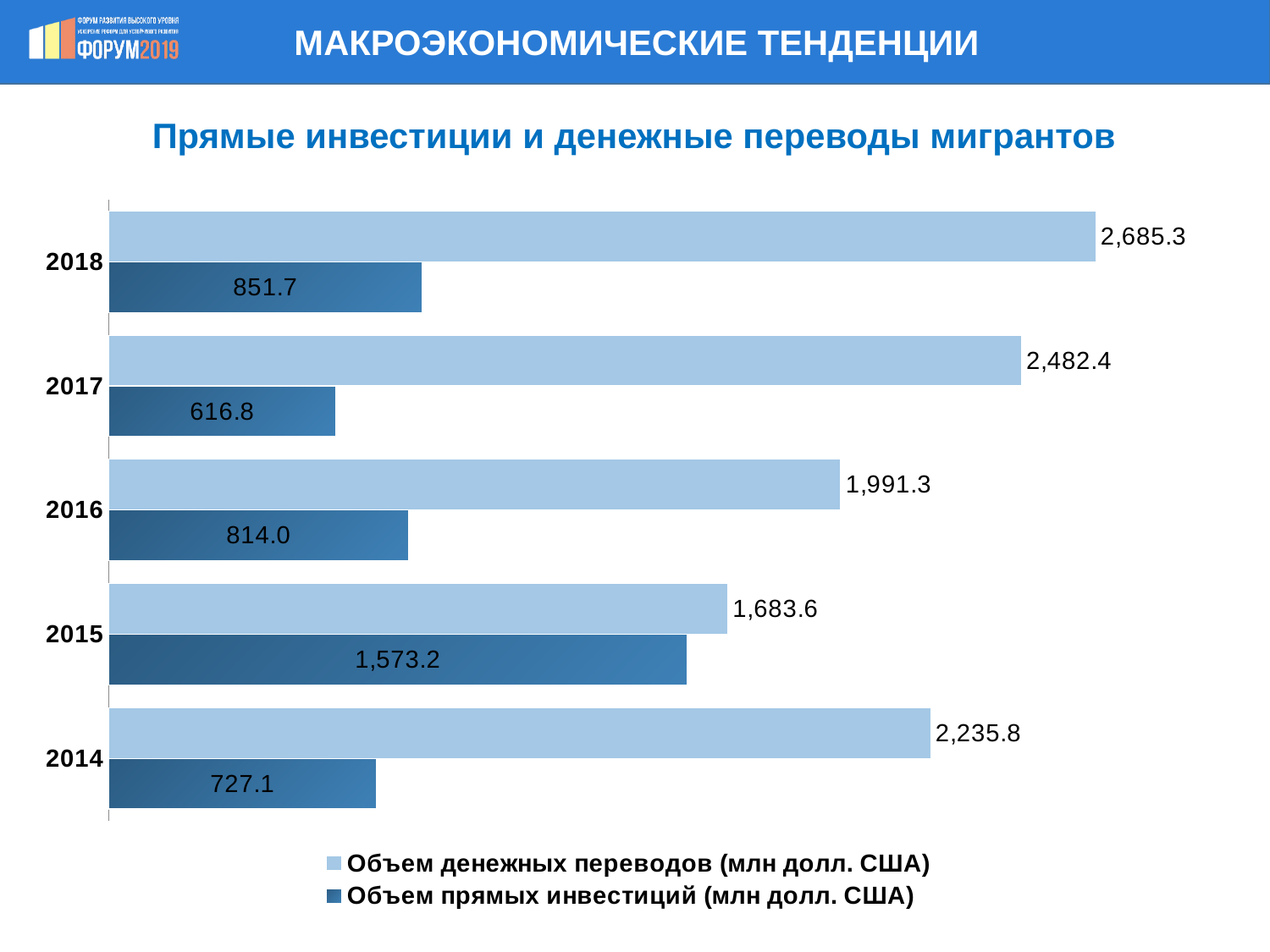
Which is larger in 2016: Объем денежных переводов or Объем прямых инвестиций? Объем денежных переводов How many years are shown on the chart? 5 What is the title of the chart? Прямые инвестиции и денежные переводы мигрантов What is the difference between Объем денежных переводов and Объем прямых инвестиций in 2018? 1,833.6 What is the value of Объем денежных переводов (млн долл. США) for 2018? 2,685.3 Which year has the lowest value of Объем денежных переводов (млн долл. США)? 2015 How many series does the legend list? 2 Which year has the lowest value of Объем прямых инвестиций (млн долл. США)? 2017 What is the value of Объем прямых инвестиций (млн долл. США) for 2017? 616.8 Which year has the highest value of Объем денежных переводов (млн долл. США)? 2018 What is the value of Объем прямых инвестиций (млн долл. США) for 2015? 1,573.2 What kind of chart is shown on the slide? Bar chart